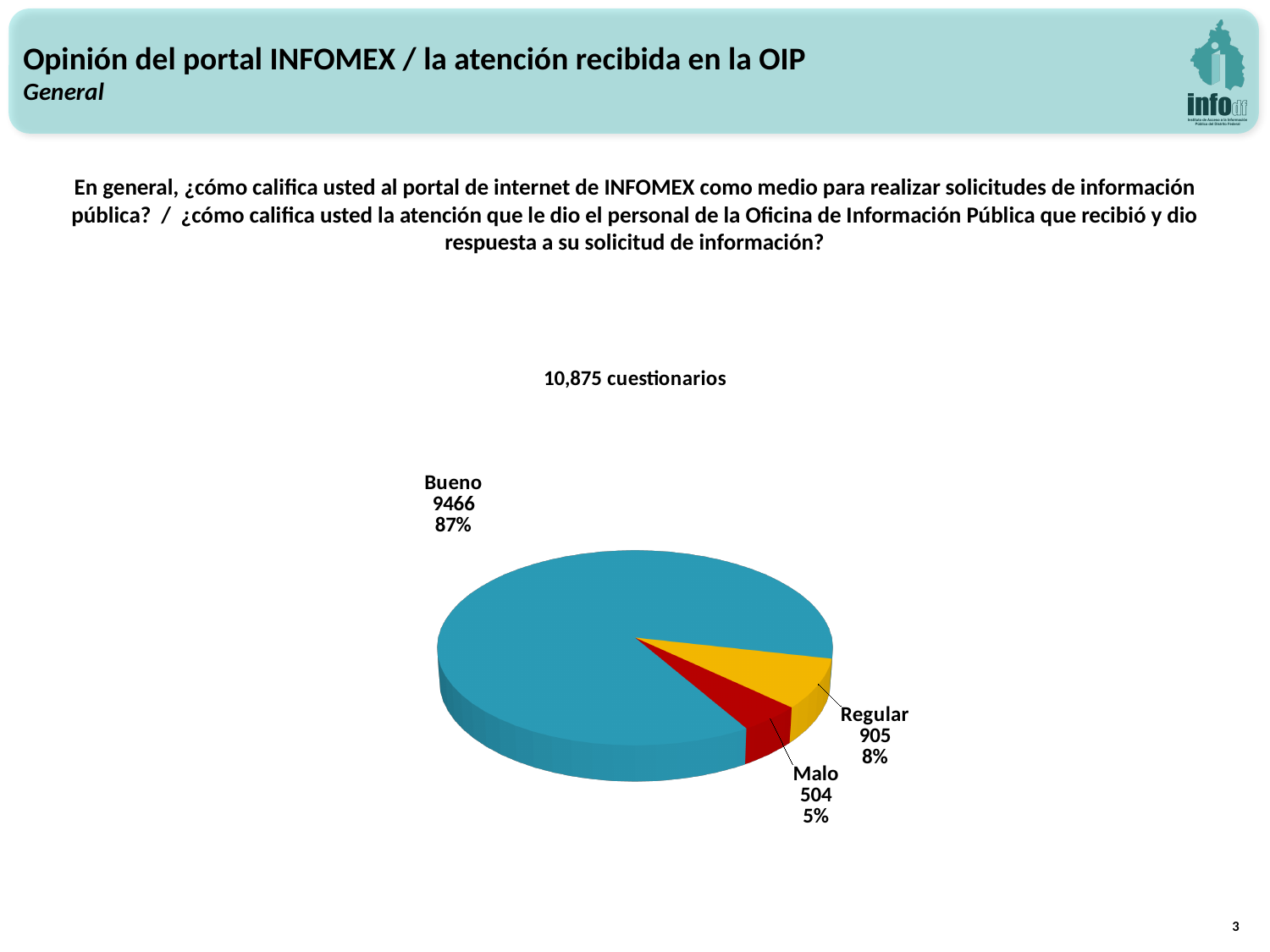
What is the title shown above the pie chart? 10,875 cuestionarios Which is larger, Regular or Malo? Regular Which category has the smallest slice? Malo What is the count for Regular? 905 What share of the pie does Bueno represent? 87% How many slices does the pie chart have? 3 What share of the pie does Malo represent? 5% What is the count for Bueno? 9466 Which category has the largest slice? Bueno What is the difference between the counts for Regular and Malo? 401 What kind of chart is shown on the slide? pie chart What is the count for Malo? 504